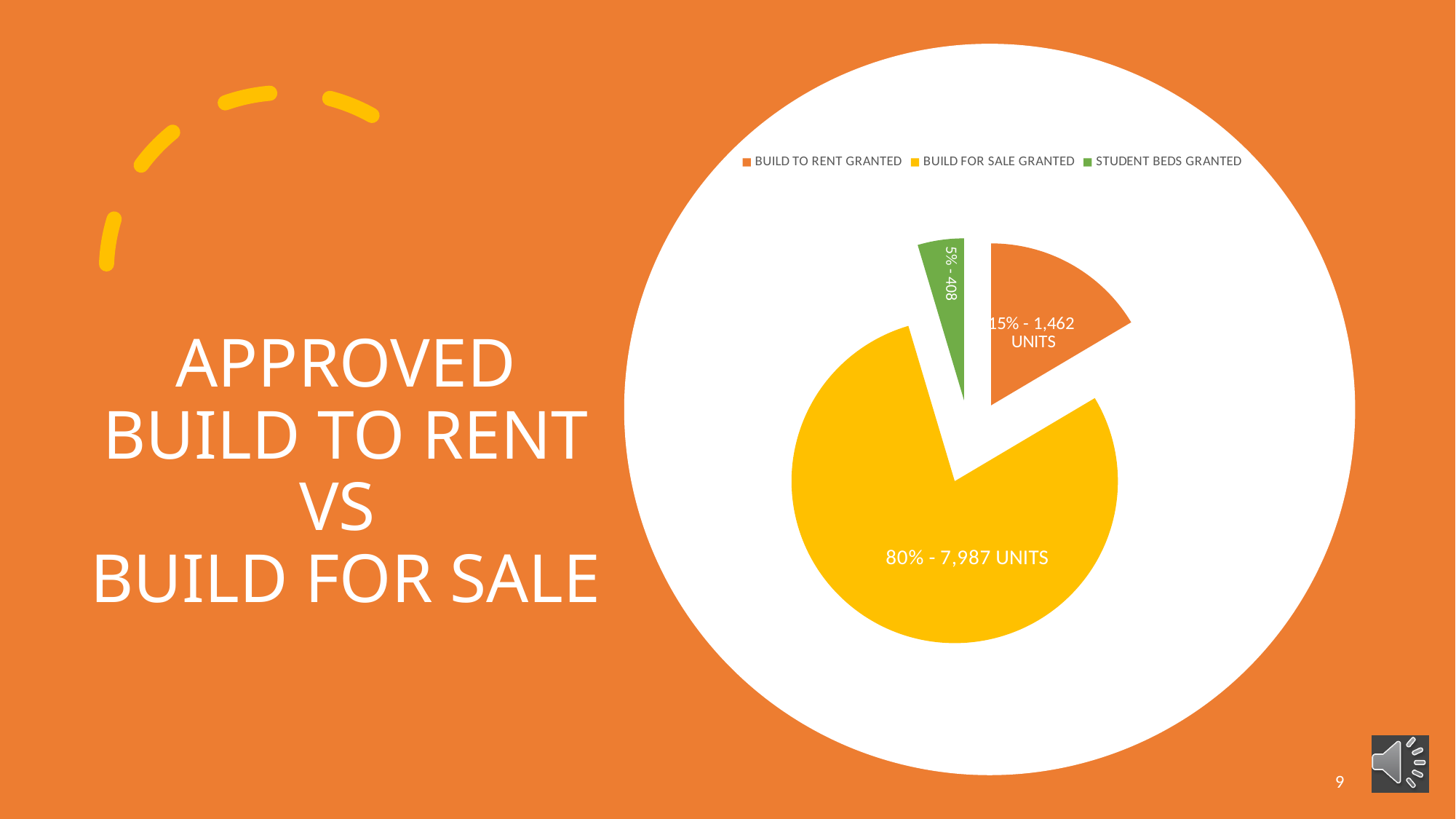
Which category has the largest slice of the pie? BUILD FOR SALE GRANTED What share of the pie does STUDENT BEDS GRANTED represent? 5% What kind of chart is shown on the slide? pie chart Which category has the smallest slice of the pie? STUDENT BEDS GRANTED How many units are shown for BUILD FOR SALE GRANTED? 7,987 UNITS What share of the pie does BUILD TO RENT GRANTED represent? 15% How many entries does the legend list? 3 How many units are shown for BUILD TO RENT GRANTED? 1,462 UNITS What is the difference in units between BUILD FOR SALE GRANTED and BUILD TO RENT GRANTED? 6,525 What value is shown for STUDENT BEDS GRANTED? 408 What share of the pie does BUILD FOR SALE GRANTED represent? 80% How many slices does the pie chart have? 3